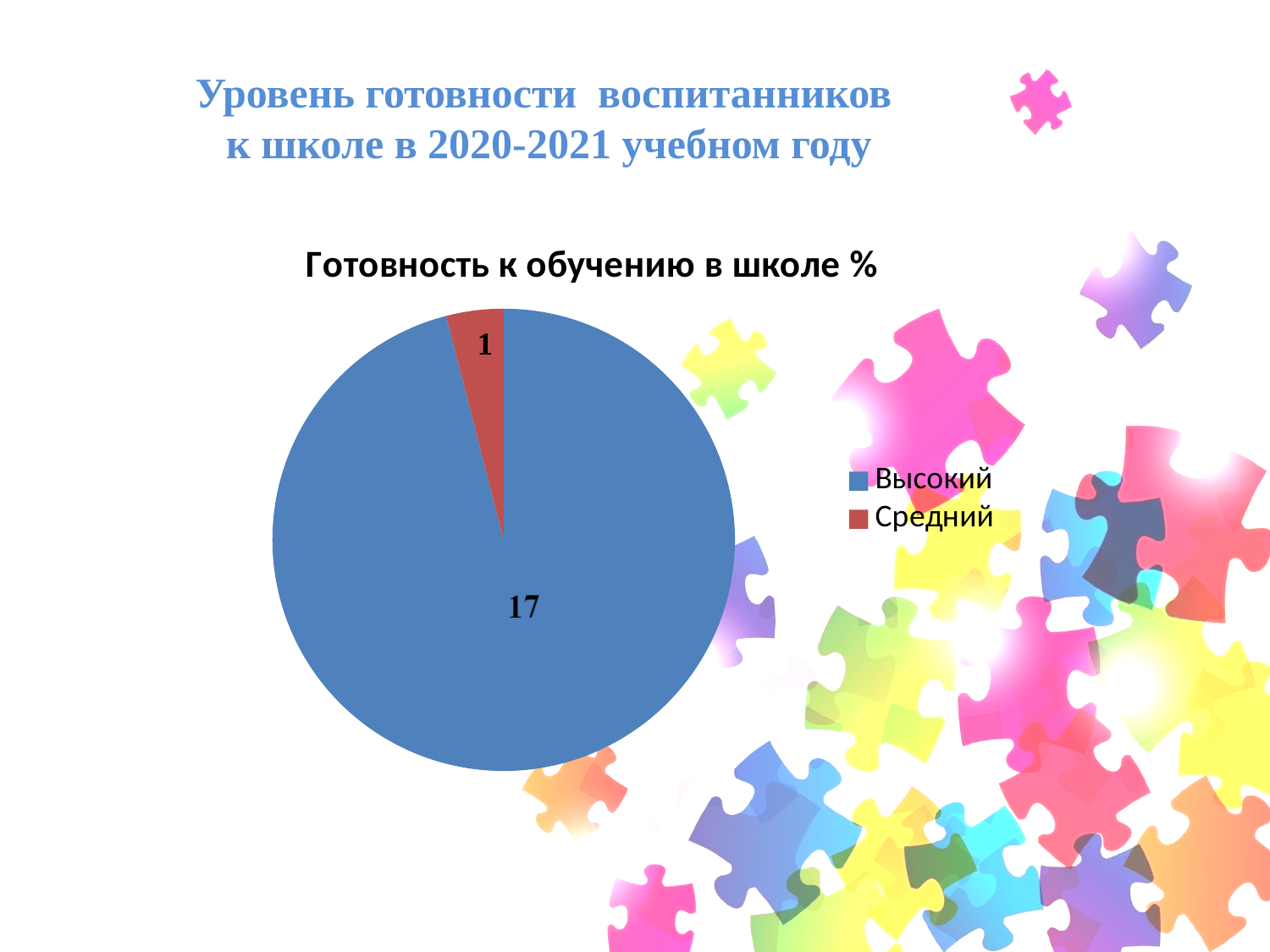
What is the difference between the values for Высокий and Средний? 16 What is the title of the chart? Готовность к обучению в школе % What kind of chart is shown on the slide? pie chart Which category has the largest slice of the pie? Высокий How many entries does the legend list? 2 Which is larger, the value for Высокий or the value for Средний? Высокий How many categories does the pie chart have? 2 What is the value for Средний in the pie chart? 1 Which category has the smallest slice of the pie? Средний What is the total of all slices in the pie chart? 18 What is the value for Высокий in the pie chart? 17 What colour is the slice for Средний? red